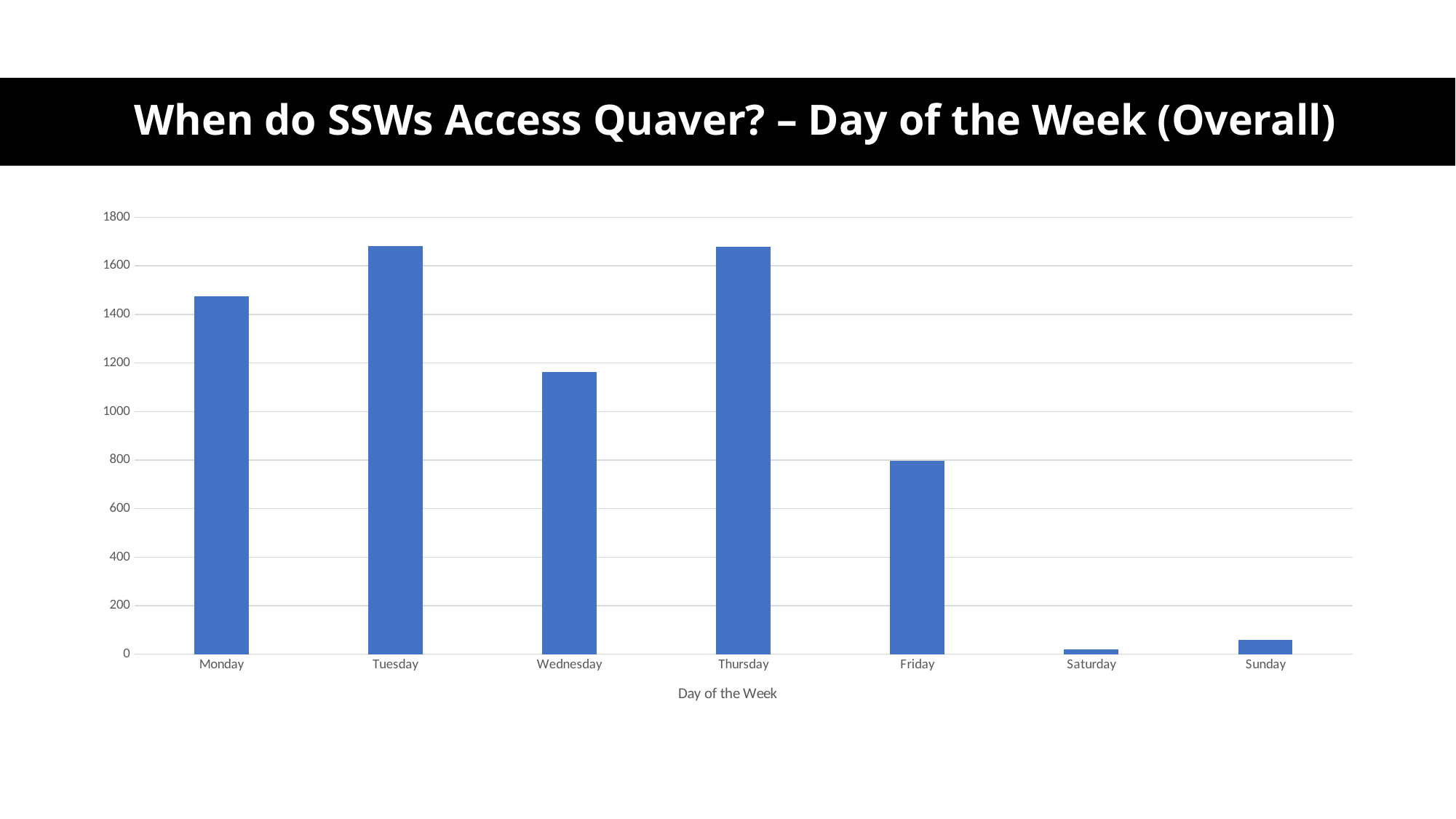
How many days of the week are plotted on the chart? 7 Which has the larger value, Tuesday or Monday? Tuesday What is the title of the horizontal axis of the chart? Day of the Week Is the value for Monday greater or less than 1400? greater Which has the larger value, Monday or Wednesday? Monday What kind of chart is shown on the slide? Bar chart Is the value for Wednesday greater or less than 1000? greater Is the value for Wednesday greater or less than 1200? less Which has the larger value, Saturday or Sunday? Sunday Which day of the week has the lowest value on the chart? Saturday